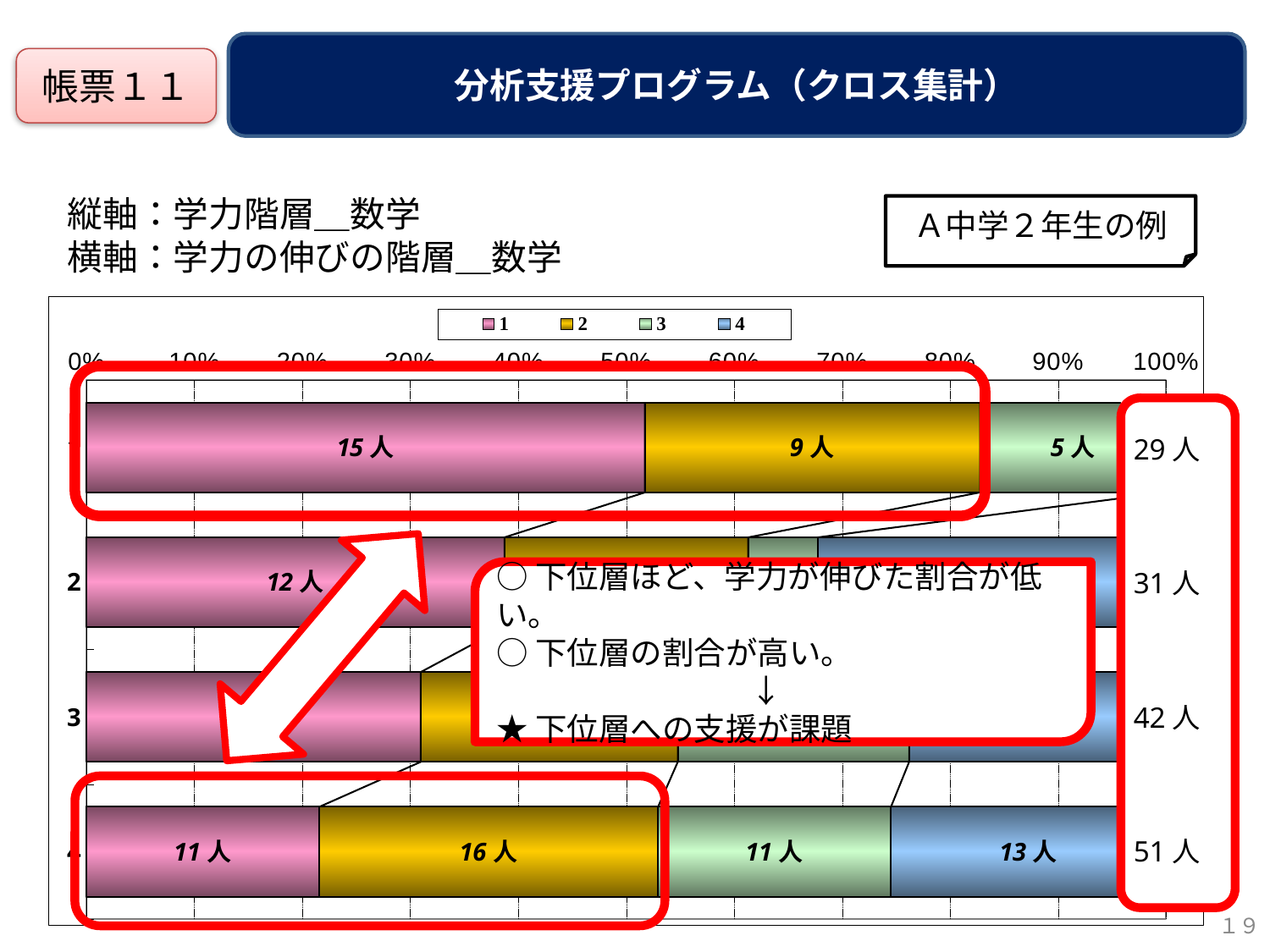
Which row has the largest total shown at the right of the chart? row 4 (51人) In the bottom bar (row 4), what is the value for series 4? 13人 In the top bar, what is the value for series 1? 15人 In the bottom bar (row 4), what is the value for series 1? 11人 How many bars (rows) are plotted in the chart? 4 In the bottom bar (row 4), what is the value for series 2? 16人 How many series does the chart legend list? 4 In the top bar, what is the value for series 3? 5人 In the bottom bar (row 4), how much larger is the series 2 value than the series 1 value? 5人 In the top bar, which is larger: the value for series 1 or the value for series 2? series 1 What is the total shown at the right end of the bar for row 2? 31人 What kind of chart is shown on the slide? stacked bar chart